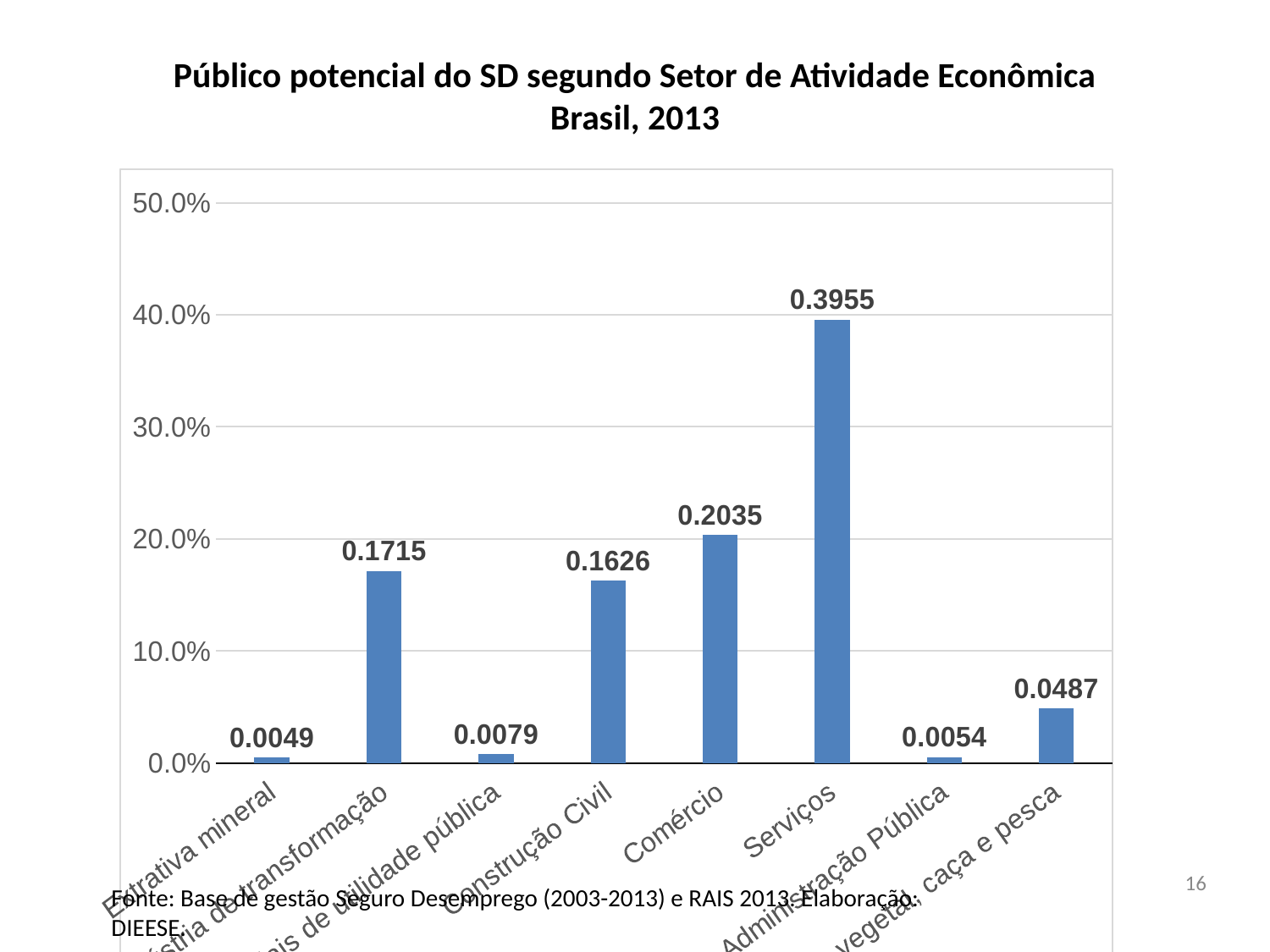
Which has a larger value, Comércio or Construção Civil? Comércio Which sector has the highest value in the chart? Serviços How many sectors (bars) are shown in the chart? 8 What is the value shown for Extrativa mineral? 0.0049 What is the value shown for Serviços? 0.3955 What kind of chart is shown on the slide? bar chart What is the value shown for Comércio? 0.2035 What is the value shown for Construção Civil? 0.1626 Which sector has the lowest value in the chart? Extrativa mineral What is the value shown for Administração Pública? 0.0054 Is the value for Serviços greater or less than 30.0%? greater What is the difference between the values for Serviços and Comércio? 0.192